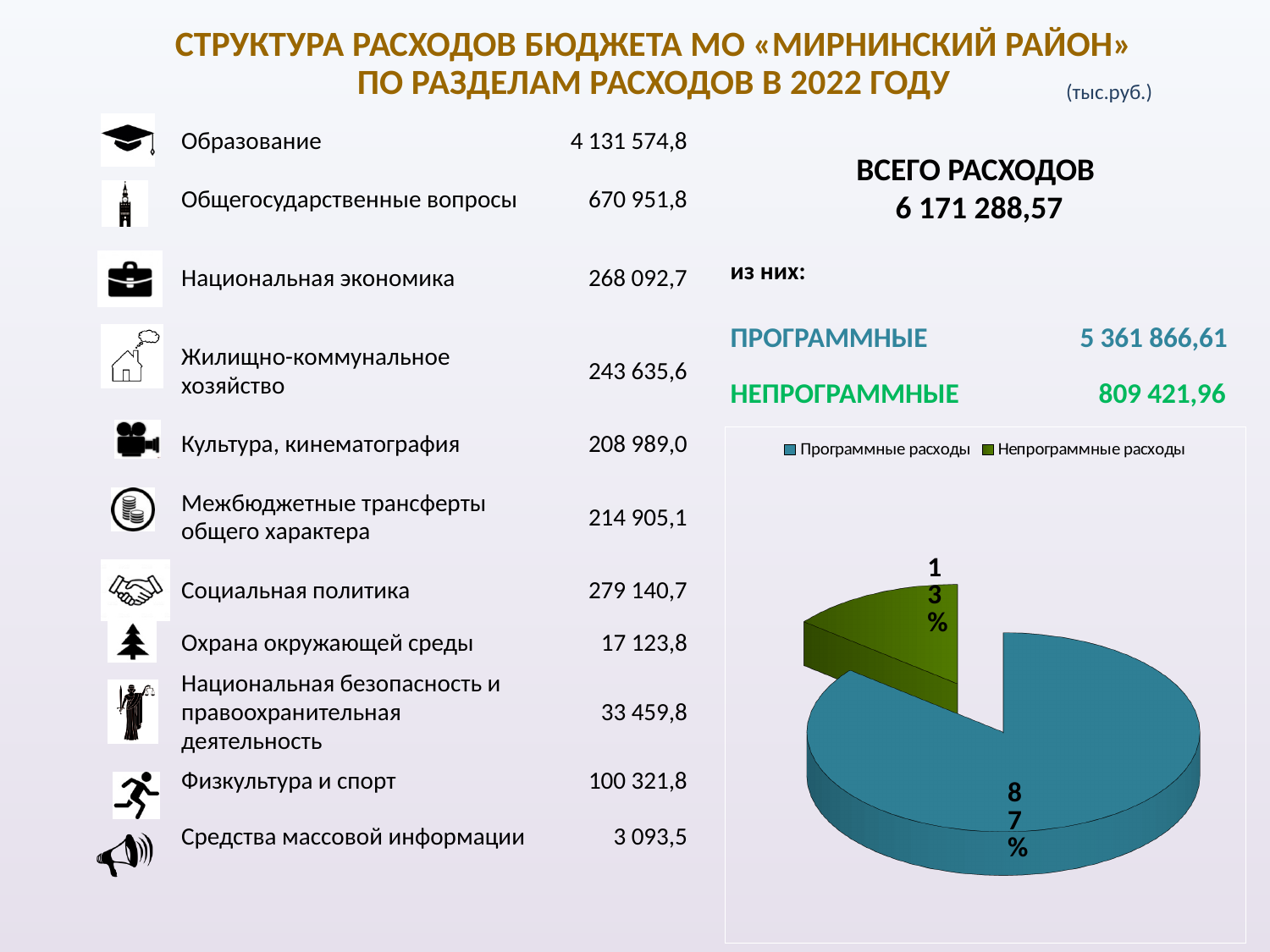
Which slice of the pie chart is the largest? Программные расходы What share of the pie chart is labelled for Непрограммные расходы? 13% In the pie chart, which is larger: Программные расходы or Непрограммные расходы? Программные расходы What kind of chart is shown on the slide? pie chart What are the two legend entries of the pie chart? Программные расходы, Непрограммные расходы What is the difference in percentage points between the Программные расходы and Непрограммные расходы slices of the pie chart? 74 Which slice of the pie chart is the smallest? Непрограммные расходы What share of the pie chart is labelled for Программные расходы? 87% How many entries does the pie chart's legend list? 2 How many slices does the pie chart have? 2 What colour is the Непрограммные расходы slice in the pie chart? green Is the share for Непрограммные расходы in the pie chart greater or less than 50%? less